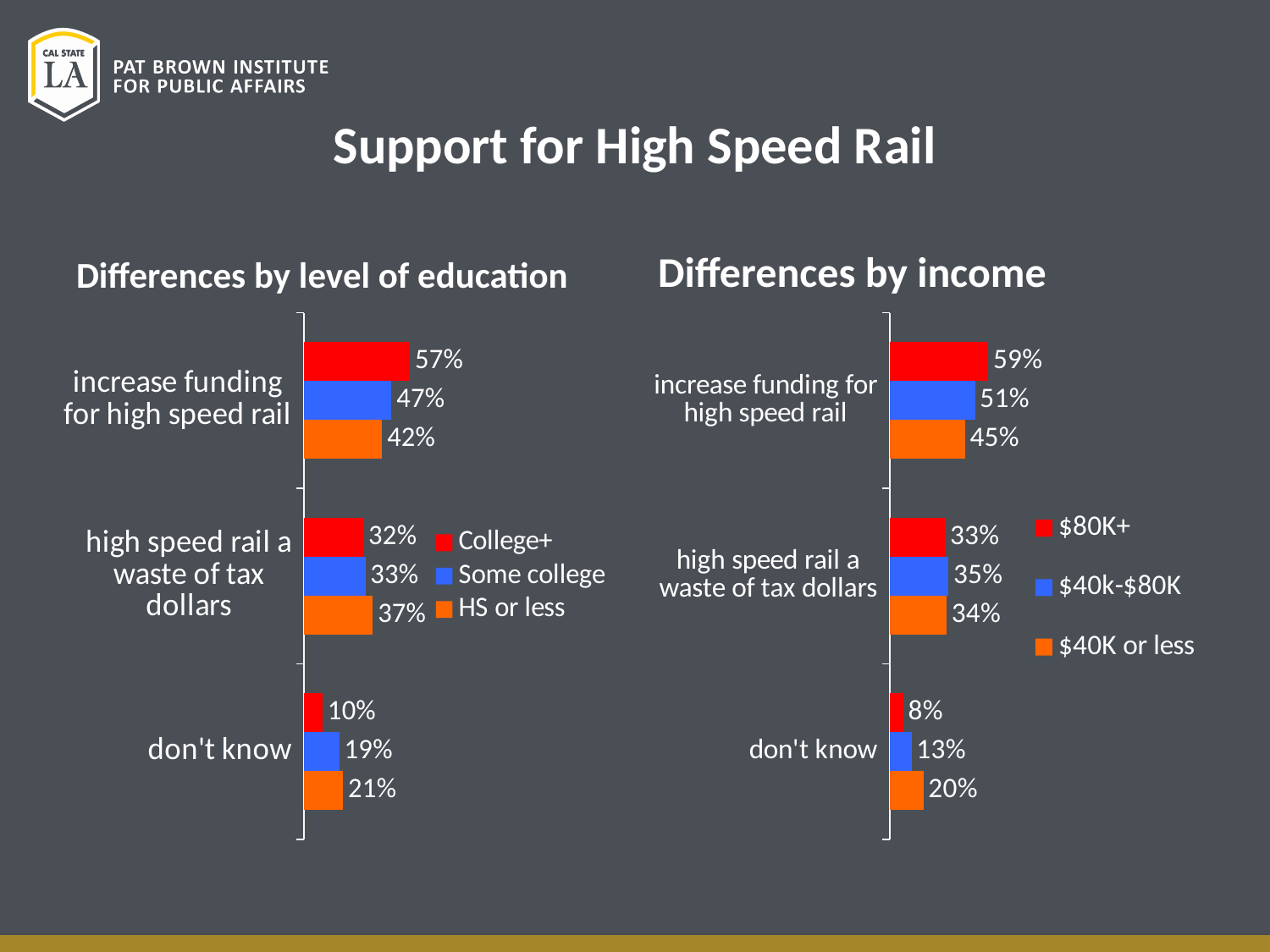
How many series does the legend of the 'Differences by level of education' chart list? 3 In the 'Differences by level of education' chart, what percentage of College+ respondents support increasing funding for high speed rail? 57% In the 'Differences by income' chart, which income group has the highest value for 'increase funding for high speed rail'? $80K+ In the 'Differences by income' chart, what percentage of $40K or less respondents say high speed rail is a waste of tax dollars? 34% What type of chart is the 'Differences by income' chart? Bar chart How many categories are shown on the 'Differences by income' chart? 3 In the 'Differences by level of education' chart, what is the 'don't know' value for HS or less? 21% In the 'Differences by income' chart, what is the difference between the $80K+ and $40K or less values for 'increase funding for high speed rail'? 14 percentage points In the 'Differences by income' chart, which colour represents the $40k-$80K series? Blue In the 'Differences by level of education' chart, which education group has the lowest 'don't know' value? College+ In the 'Differences by level of education' chart, which is larger for 'high speed rail a waste of tax dollars': HS or less or College+? HS or less In the 'Differences by level of education' chart, what is the difference between the Some college and College+ values for 'don't know'? 9 percentage points